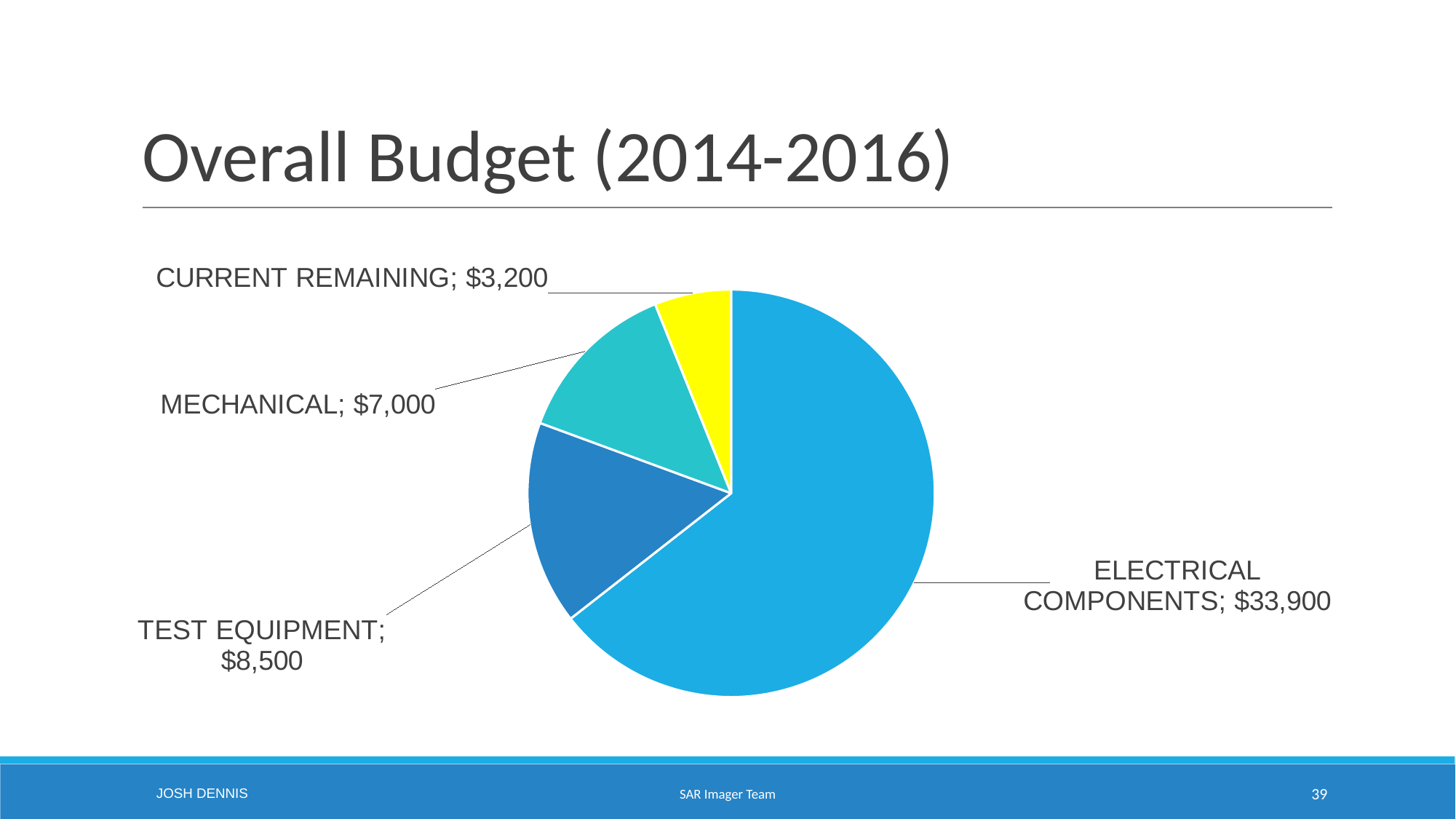
Which is larger, the value for Mechanical or the value for Current Remaining? Mechanical Which category has the largest slice of the pie chart? Electrical Components How many categories are shown in the pie chart? 4 Which category has the smallest slice of the pie chart? Current Remaining What kind of chart is shown on the slide? Pie chart What is the total of all the values shown in the pie chart? $52,600 What is the title of the slide containing the pie chart? Overall Budget (2014-2016) What is the difference between the Test Equipment and Mechanical values? $1,500 What is the value for Current Remaining in the pie chart? $3,200 What is the value for Electrical Components in the pie chart? $33,900 What is the value for Mechanical in the pie chart? $7,000 What is the value for Test Equipment in the pie chart? $8,500